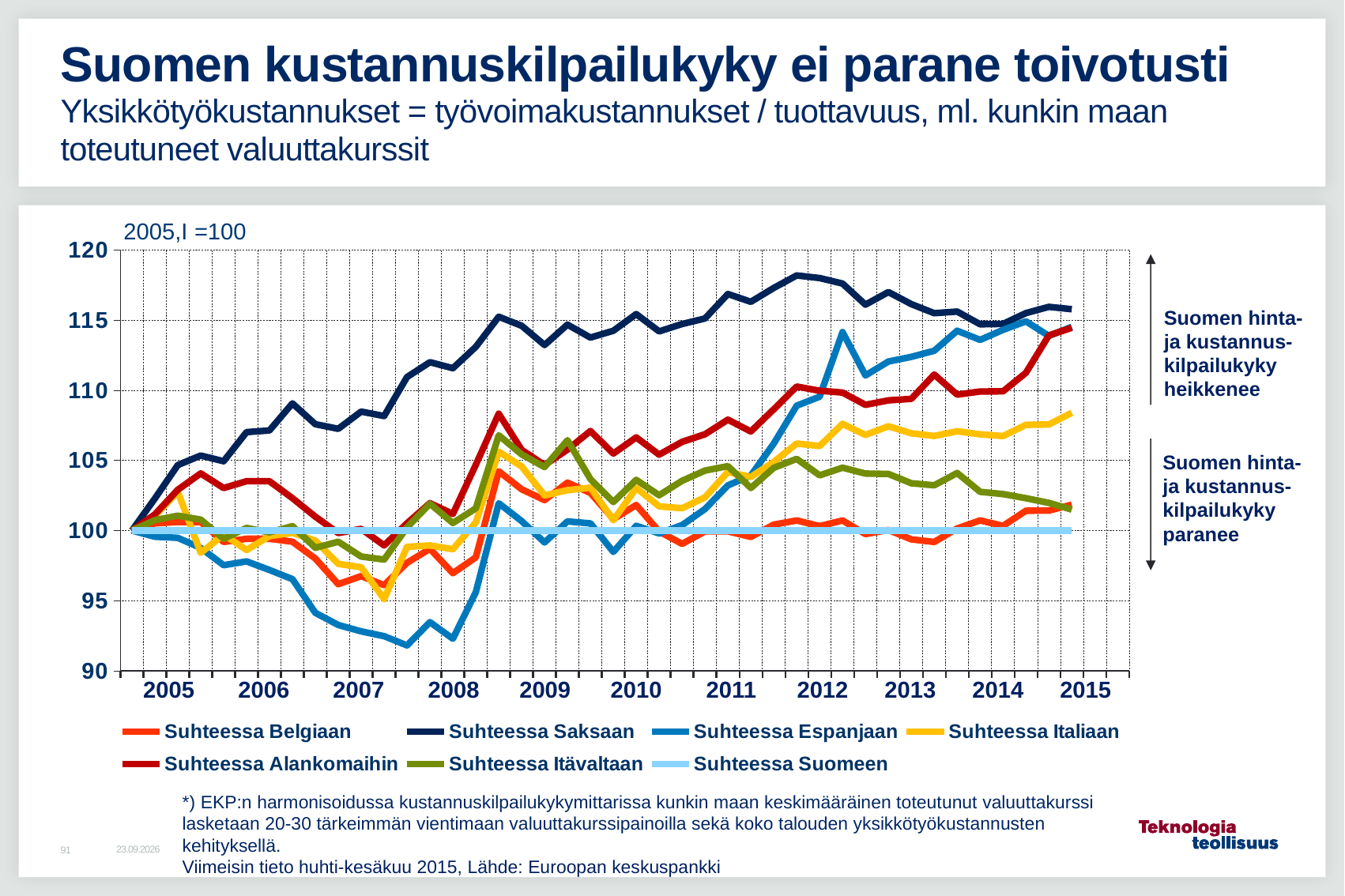
Is the value for 'Suhteessa Italiaan' at the end of the chart (2015) greater or less than 105? greater What is the index base stated above the chart? 2005,I =100 What value does the 'Suhteessa Suomeen' line stay at throughout the chart? 100 In 2012, which is larger: the value for 'Suhteessa Saksaan' or 'Suhteessa Belgiaan'? Suhteessa Saksaan Does the 'Suhteessa Saksaan' line rise or fall from 2005 to 2015 overall? rise Which series is the highest at the end of the chart in 2015? Suhteessa Saksaan How many year labels are shown on the x axis? 11 What kind of chart is shown on the slide? line chart Which series is the lowest in 2007? Suhteessa Espanjaan Is the value for 'Suhteessa Espanjaan' in 2007 greater or less than 95? less Is the value for 'Suhteessa Saksaan' in 2012 greater or less than 115? greater How many series does the legend list? 7